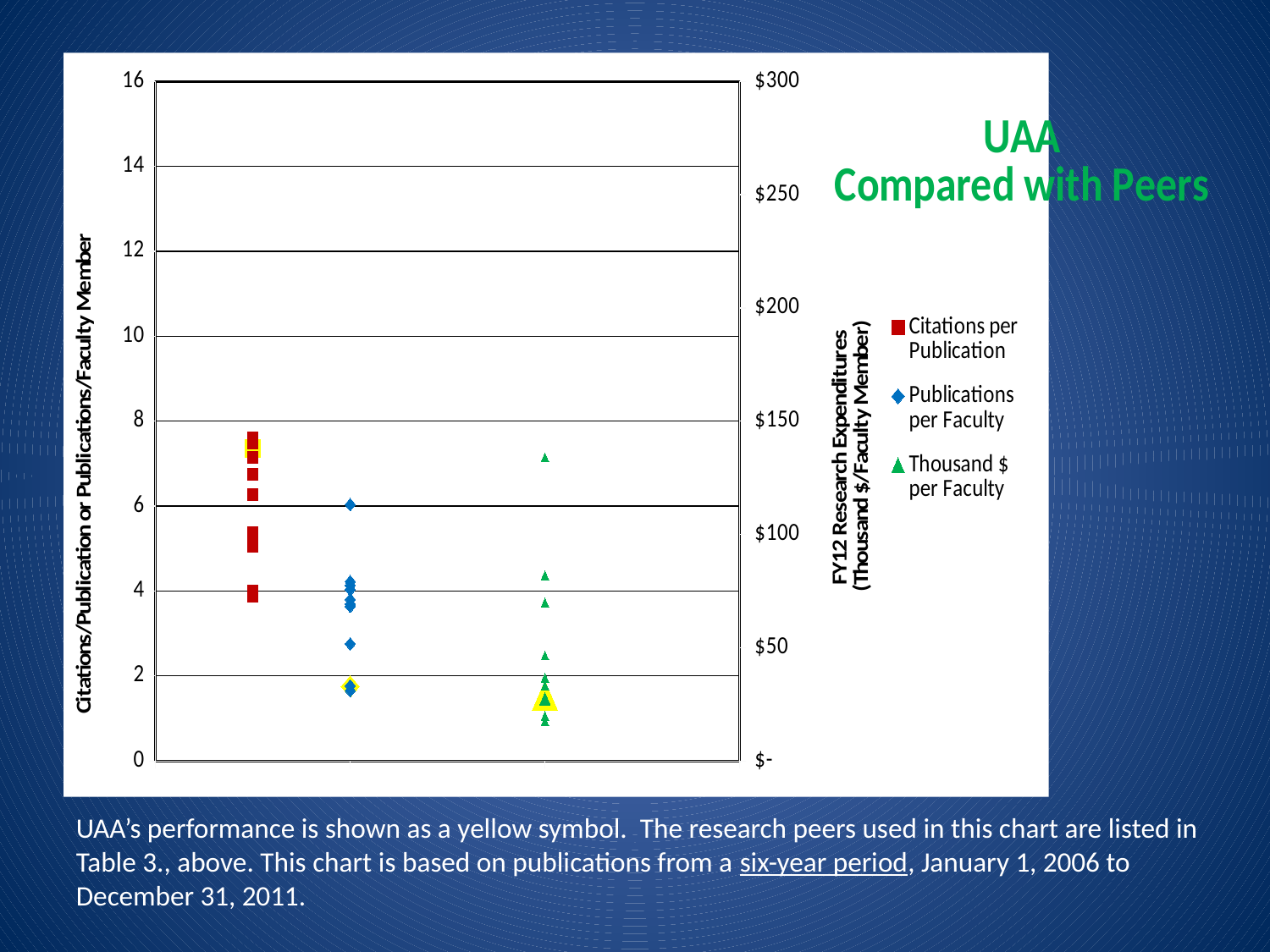
Which series reaches the highest value on the left axis: Citations per Publication or Publications per Faculty? Citations per Publication Is the highest plotted value for Publications per Faculty greater or less than 5? greater Which series is plotted with green triangles? Thousand $ per Faculty Is the lowest plotted value for Citations per Publication greater or less than 6? less What is the title shown next to the chart? UAA Compared with Peers What kind of chart is shown on the slide? scatter chart Is UAA's value (yellow symbol) for Citations per Publication greater or less than 6? greater How many series does the chart's legend list? 3 For UAA (yellow symbols), which is larger: Citations per Publication or Publications per Faculty? Citations per Publication